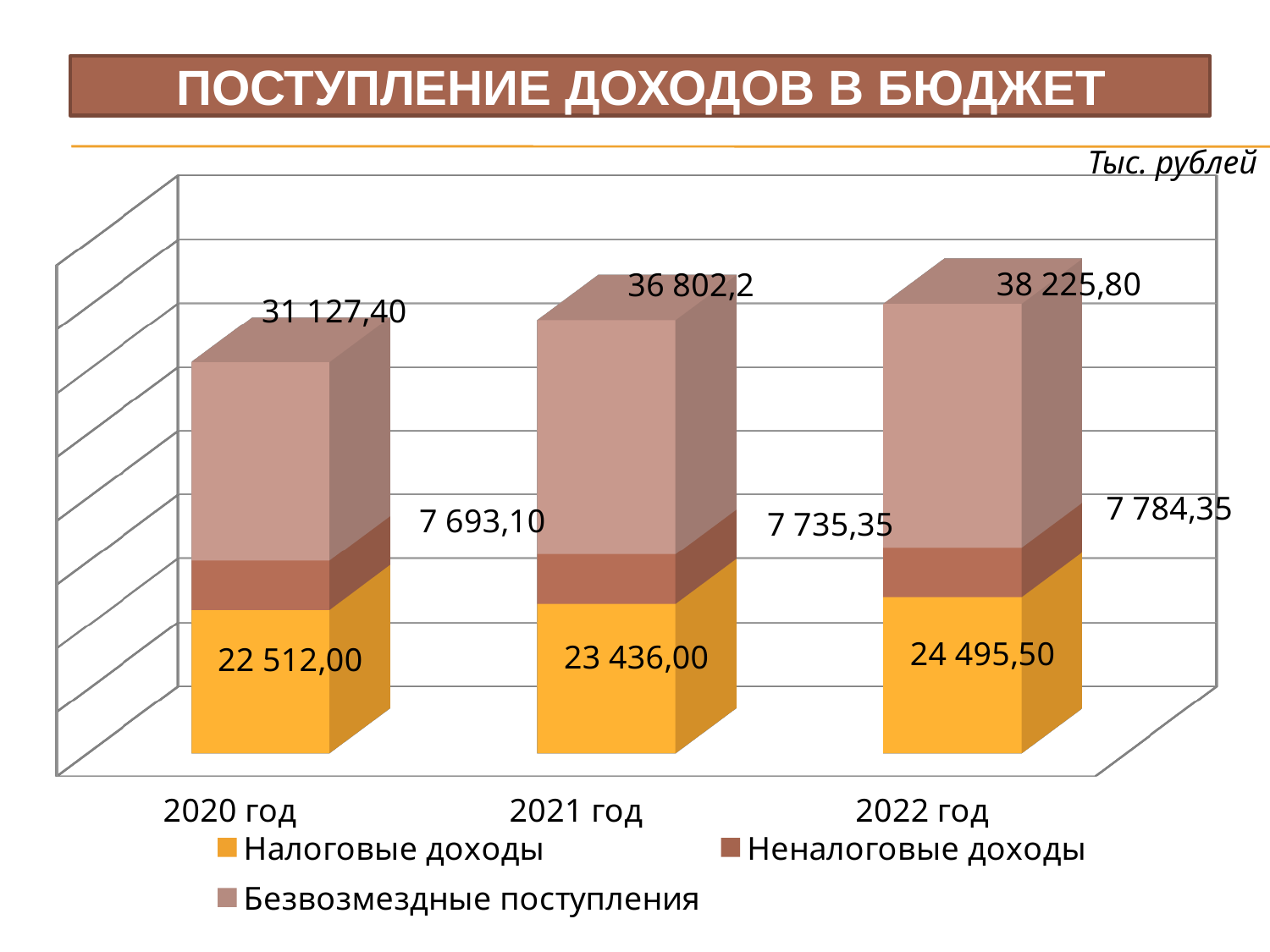
How many years are shown on the x axis? 3 What is the value of Безвозмездные поступления for 2021 год? 36 802,2 Do the values of Налоговые доходы rise or fall from 2020 год to 2022 год? Rise How many series does the legend list? 3 What is the difference between Налоговые доходы in 2022 год and 2020 год? 1 983,50 What is the value of Безвозмездные поступления for 2022 год? 38 225,80 In which year is Безвозмездные поступления the lowest? 2020 год What type of chart is shown on the slide? Stacked bar chart What is the value of Налоговые доходы for 2020 год? 22 512,00 In which year is Налоговые доходы the highest? 2022 год What is the value of Неналоговые доходы for 2021 год? 7 735,35 Which is larger: Безвозмездные поступления in 2021 год or in 2022 год? 2022 год